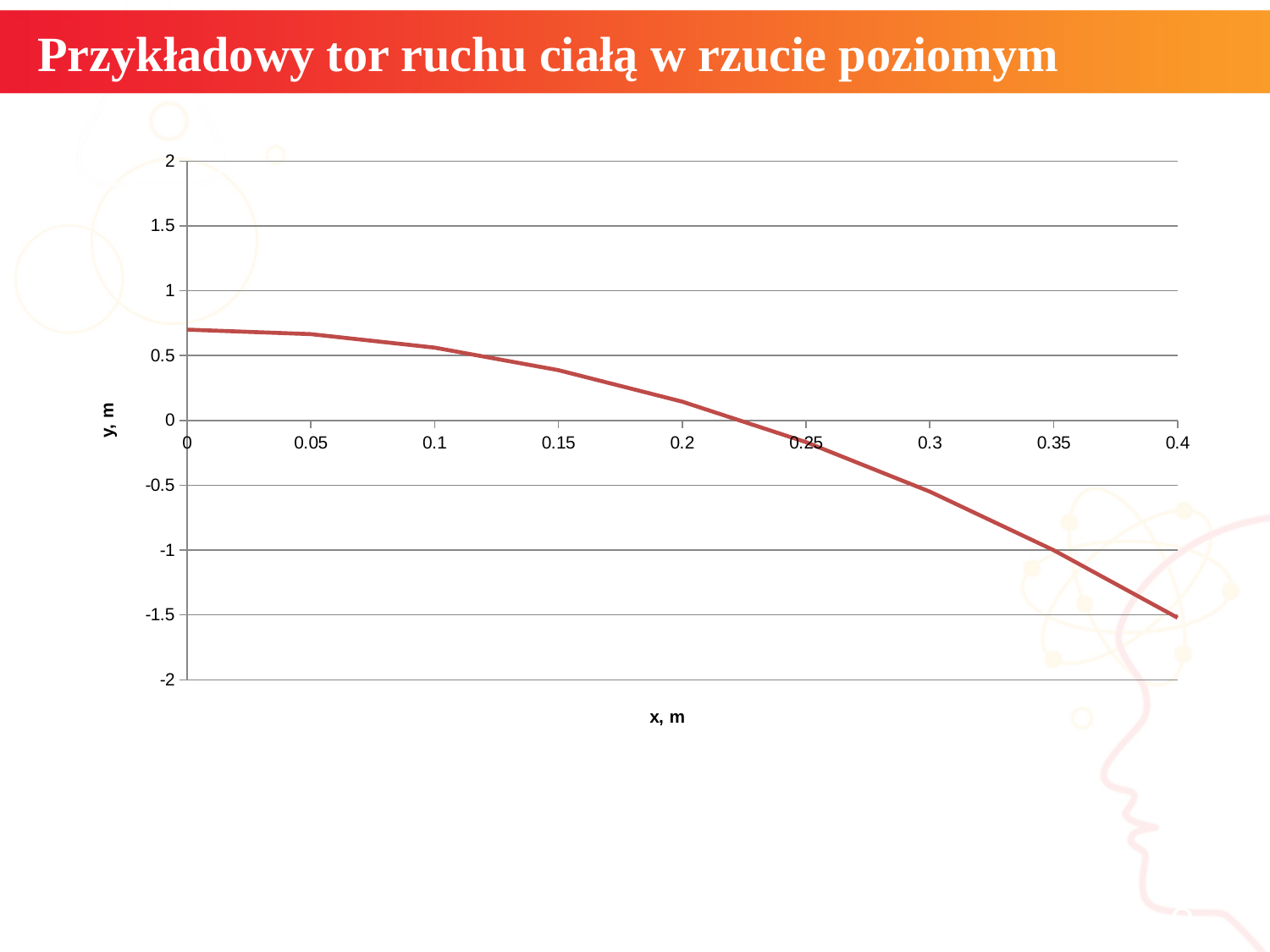
Which has the larger y value: x = 0 or x = 0.4? x = 0 What kind of chart is shown on the slide? line chart What is the title of the slide chart? Przykładowy tor ruchu ciałą w rzucie poziomym Do the y values rise or fall as x increases along the x axis? fall What is the highest value shown on the y axis? 2 What is the label of the horizontal axis? x, m Is the y value at x = 0.2 greater or less than 0? greater Is the y value at x = 0.15 greater or less than 0.5? less Is the y value at x = 0.4 greater or less than -1? less